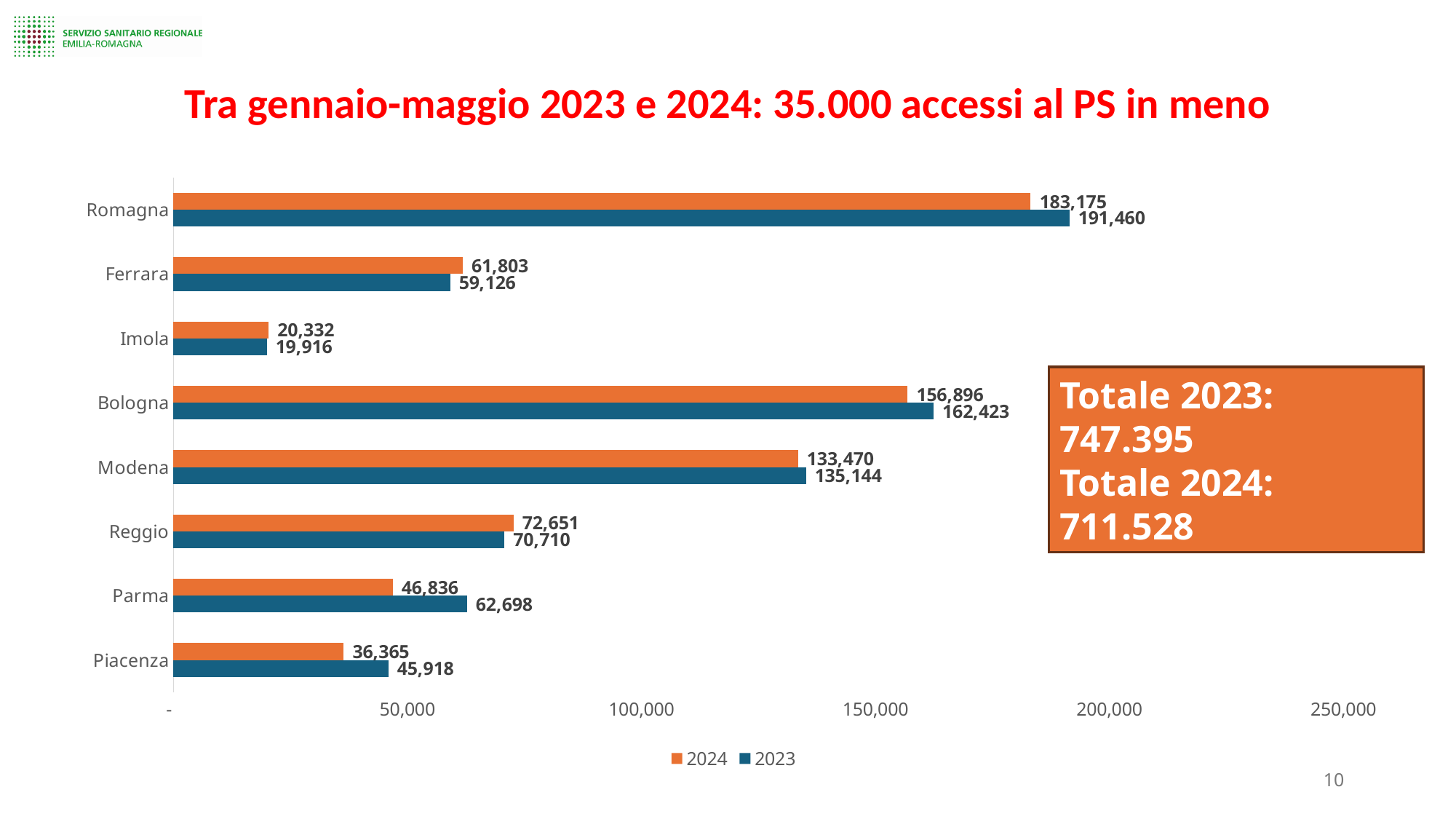
For Ferrara, which series has the larger value, 2024 or 2023? 2024 What is the value for Romagna in the 2023 series? 191,460 How many categories are shown on the chart? 8 Which category has the highest value in the 2024 series? Romagna What is the value for Imola in the 2023 series? 19,916 What is the value for Parma in the 2024 series? 46,836 How many series does the legend list? 2 What kind of chart is shown on the slide? bar chart What is the difference between the 2023 and 2024 values for Parma? 15,862 Which category has the lowest value in the 2023 series? Imola What is the difference between the 2023 and 2024 values for Romagna? 8,285 Is the 2023 value for Modena greater or less than 100,000? greater